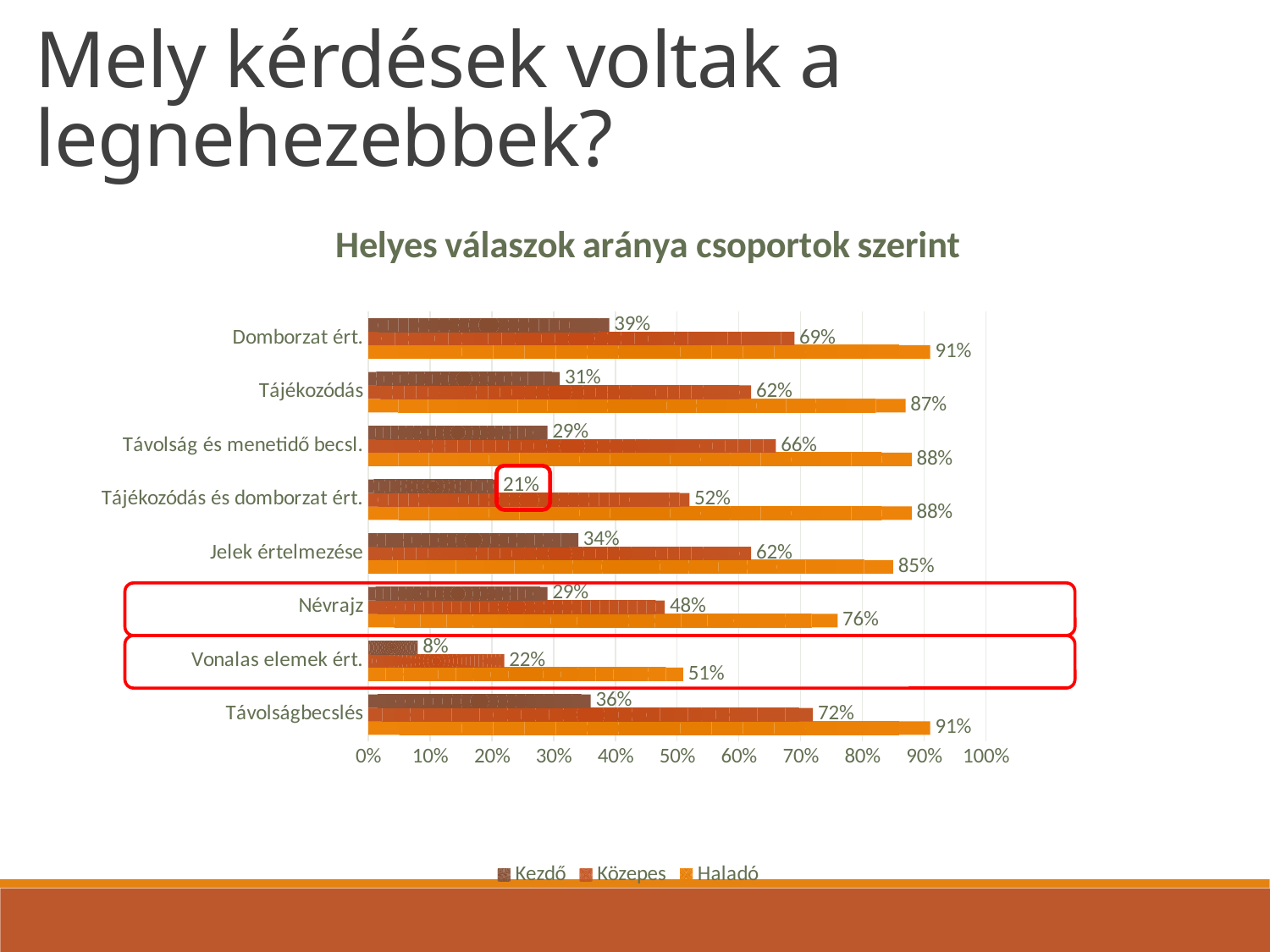
What is the Kezdő value for Tájékozódás és domborzat ért.? 21% Which category has the lowest Kezdő value? Vonalas elemek ért. What is the title of the chart? Helyes válaszok aránya csoportok szerint What is the Haladó value for Domborzat ért.? 91% Which category has the highest Közepes value? Távolságbecslés What is the Kezdő value for Távolságbecslés? 36% How many series does the legend list? 3 What is the Közepes value for Névrajz? 48% What type of chart is shown on the slide? bar chart What is the difference between the Haladó and Kezdő values for Vonalas elemek ért.? 43% How many categories are shown on the chart? 8 Which is larger: the Közepes value for Tájékozódás or the Közepes value for Távolság és menetidő becsl.? Távolság és menetidő becsl.